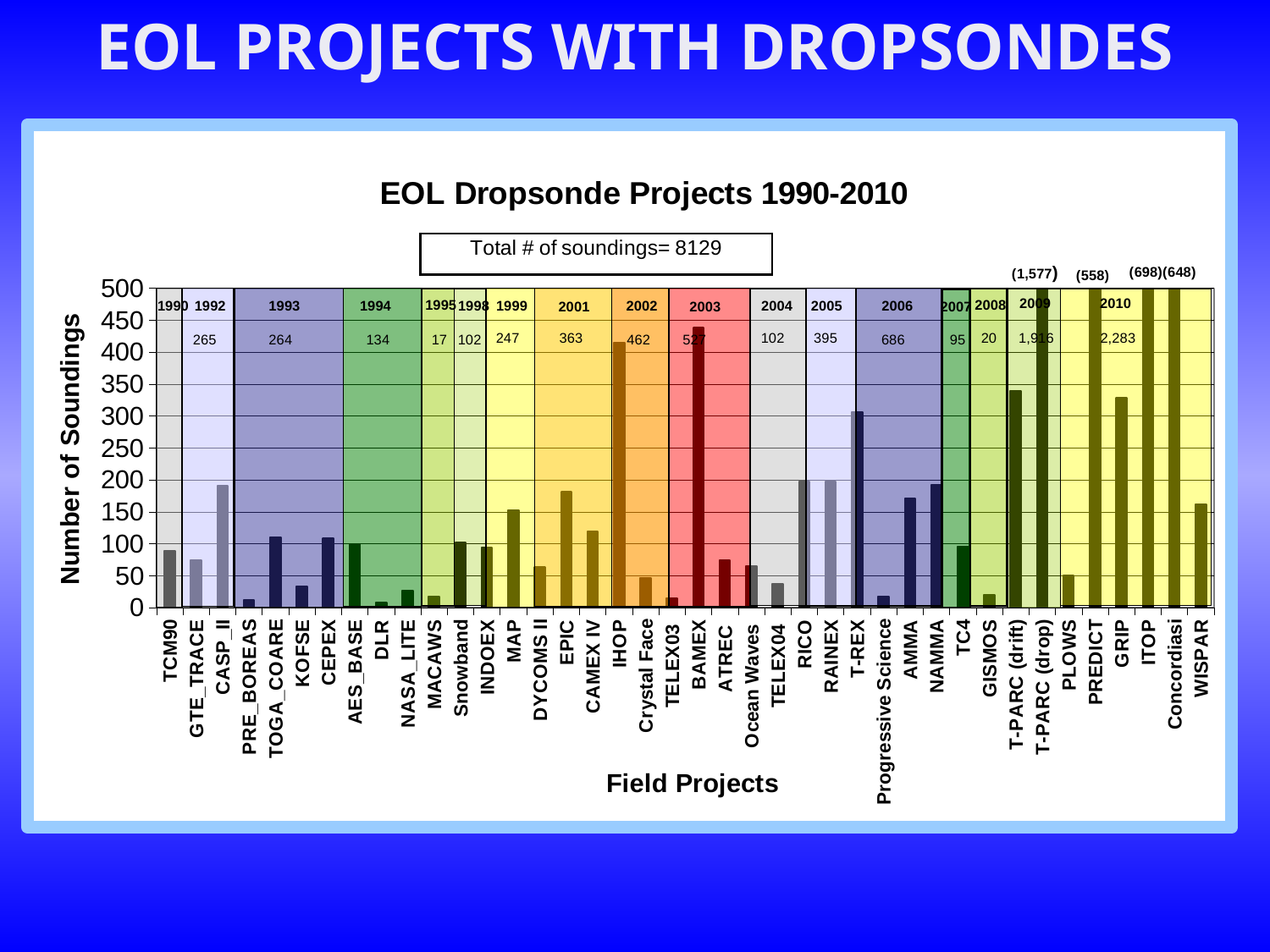
Is the value for IHOP greater or less than 400? greater What is the number of soundings shown for the year 2006? 686 How many soundings are labelled for ITOP? 698 Is the value for TELEX03 greater or less than 50? less Which field project has the highest number of soundings? T-PARC (drop) What is the number of soundings shown for the year 2010? 2,283 What is the total number of soundings stated on the chart? 8129 What kind of chart is shown on the slide? Bar chart How many soundings are labelled for T-PARC (drop)? 1,577 What is the difference in soundings between ITOP and Concordiasi? 50 What is the title of the chart? EOL Dropsonde Projects 1990-2010 How many soundings are labelled for Concordiasi? 648